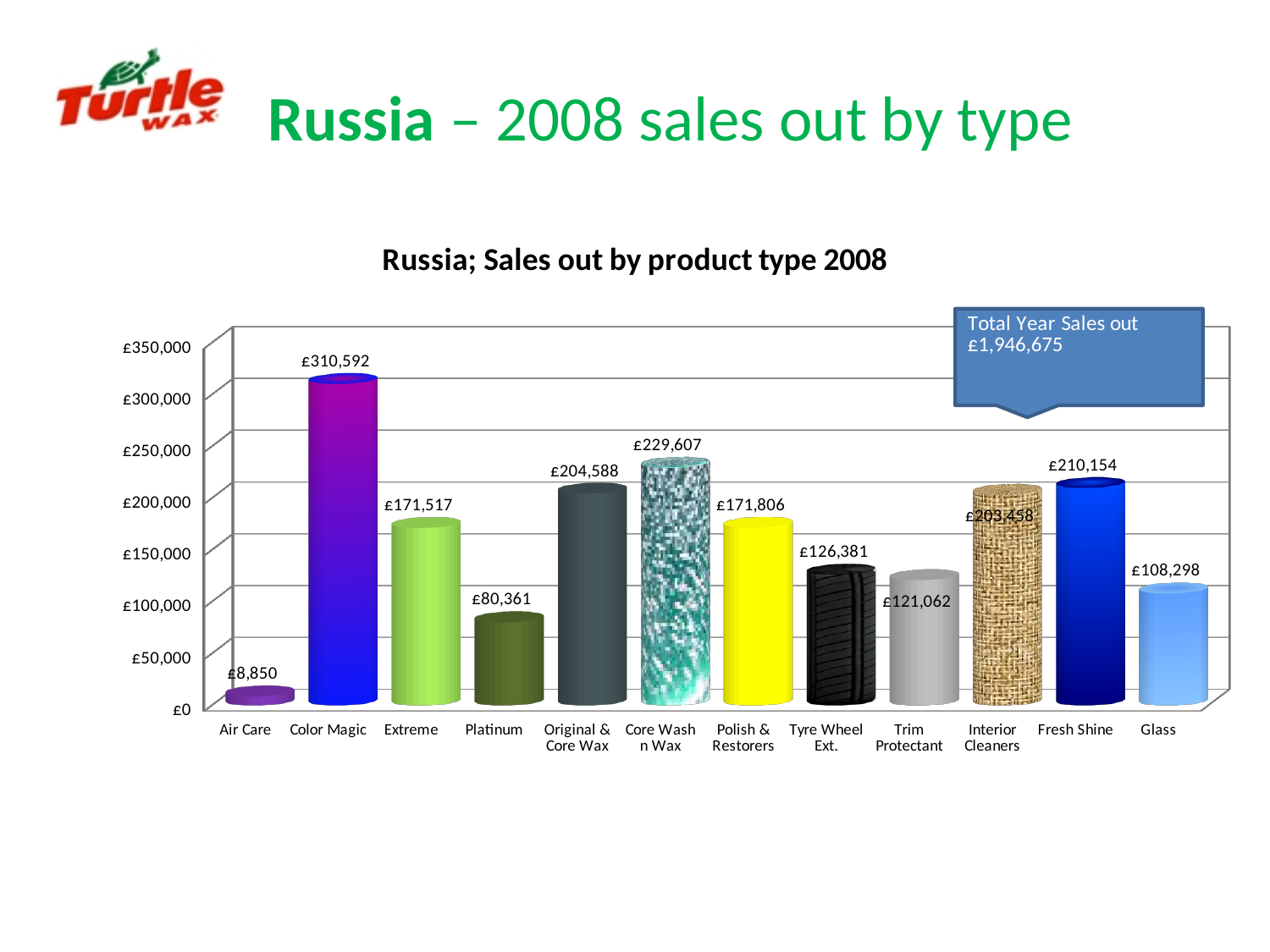
What is the difference in sales between Glass and Platinum? £27,937 What is the sales value for Trim Protectant? £121,062 What is the sales value for Core Wash n Wax? £229,607 Which product type has the lowest sales? Air Care What is the difference in sales between Color Magic and Core Wash n Wax? £80,985 What is the sales value for Glass? £108,298 Is the value for Tyre Wheel Ext. greater or less than £100,000? greater What is the total year sales out shown in the callout box? £1,946,675 Which has higher sales, Platinum or Glass? Glass Which product type has the highest sales? Color Magic How many product types are shown on the chart? 12 What is the sales value for Color Magic? £310,592